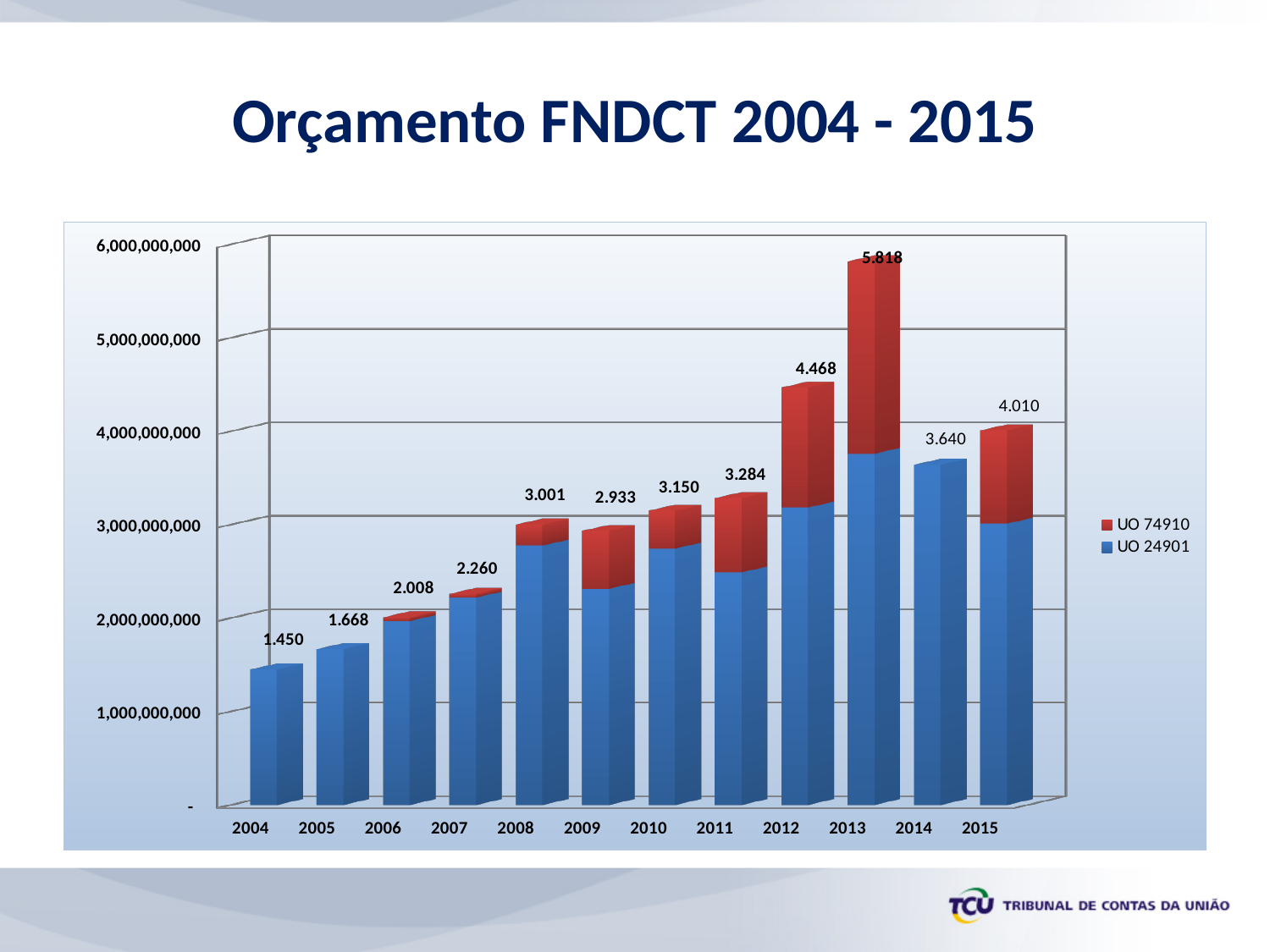
How many series does the legend list? 2 What kind of chart is shown on the slide? Stacked bar chart What is the data label shown on the bar for 2013? 5.818 Which year has the lowest total bar? 2004 Which year has a larger labelled total, 2008 or 2009? 2008 What is the data label shown on the bar for 2014? 3.640 Which year has the highest total bar? 2013 How many years are shown on the x axis? 12 Which series is shown in red in the legend? UO 74910 What is the data label shown on the bar for 2004? 1.450 Is the UO 24901 (blue) portion of the 2010 bar greater or less than 3,000,000,000? less What is the difference between the labelled totals for 2013 and 2012? 1.350